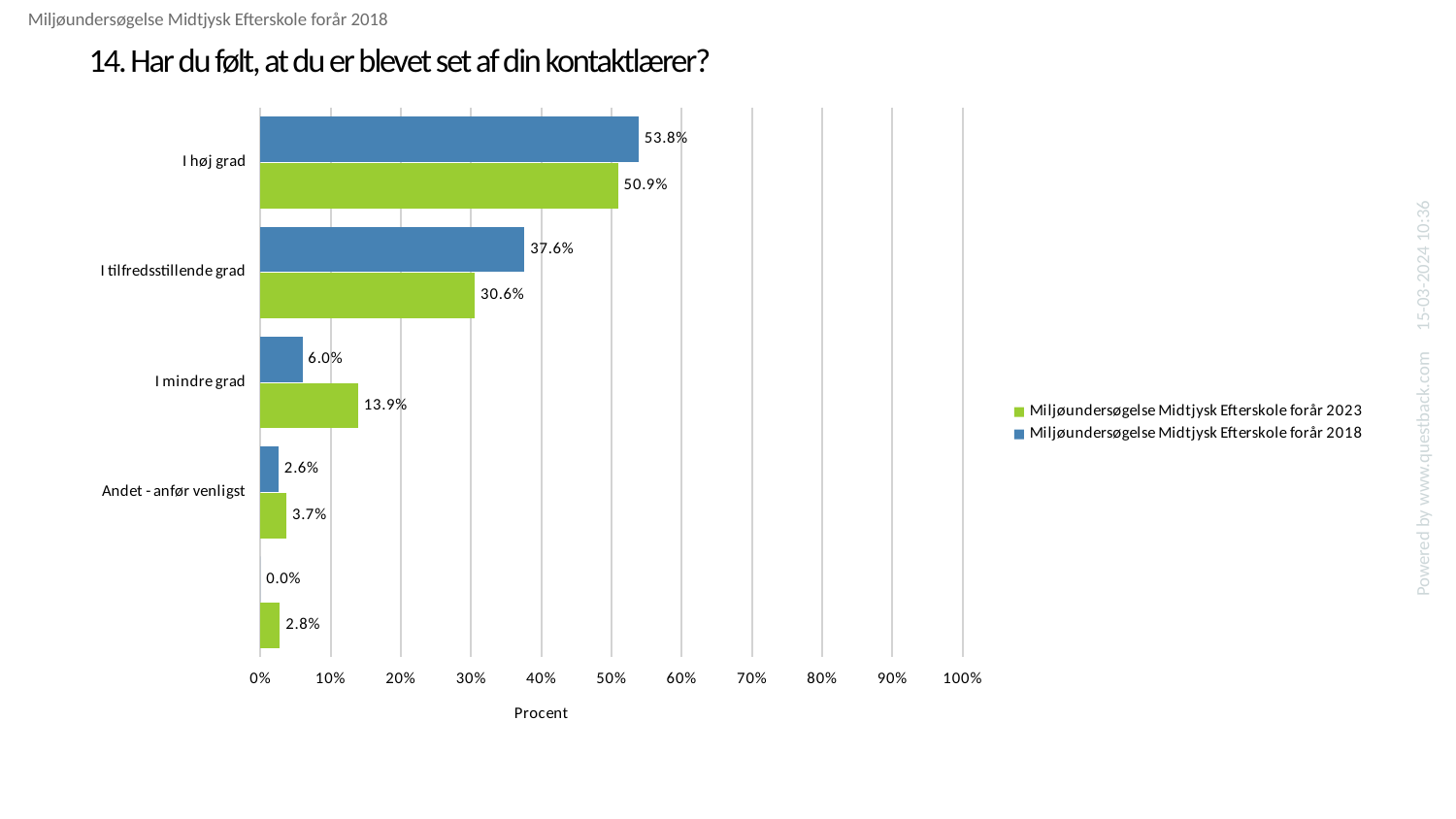
Which labelled category has the lowest value in the 2018 series? Andet - anfør venligst What is the value for "I mindre grad" in the 2018 series? 6.0% How many series does the legend list? 2 What is the value for "I tilfredsstillende grad" in the Miljøundersøgelse Midtjysk Efterskole forår 2023 series? 30.6% What is the difference between the 2018 and 2023 values for "I tilfredsstillende grad"? 7.0 percentage points Which category has the highest value in the 2023 series? I høj grad What is the value for "Andet - anfør venligst" in the 2023 series? 3.7% For "I mindre grad", which series has the larger value, 2018 or 2023? 2023 Is the 2018 value for "I høj grad" greater or less than 50%? greater What is the difference between the 2023 and 2018 values for "I mindre grad"? 7.9 percentage points What is the value for "I høj grad" in the Miljøundersøgelse Midtjysk Efterskole forår 2018 series? 53.8% What kind of chart is shown on the slide? Bar chart